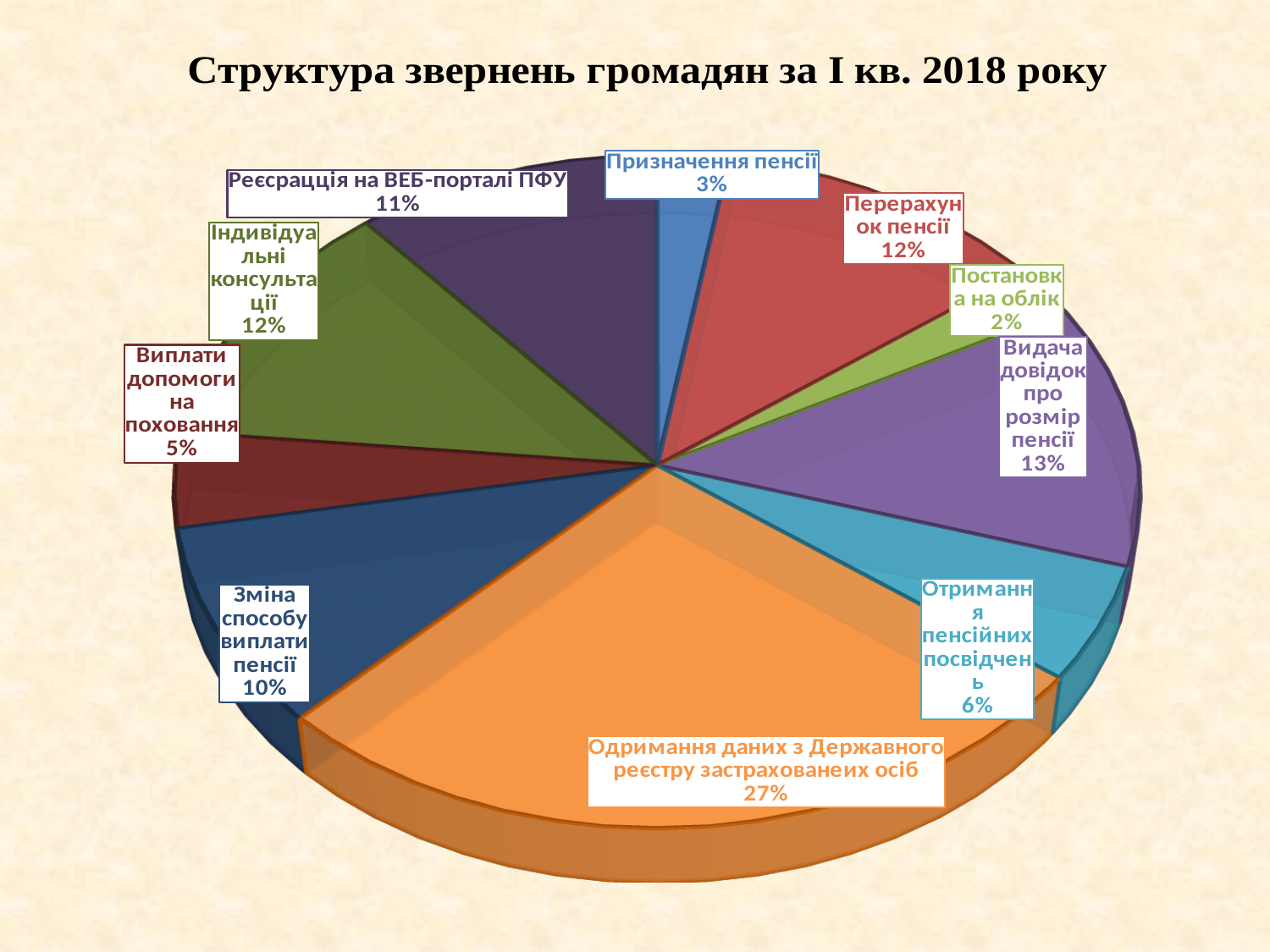
What kind of chart is shown on the slide? pie chart Which is larger: "Реєсрацція на ВЕБ-порталі ПФУ" or "Виплати допомоги на поховання"? Реєсрацція на ВЕБ-порталі ПФУ What percentage is shown for "Постановка на облік"? 2% How many slices does the pie chart have? 10 What percentage is shown for "Зміна способу виплати пенсії"? 10% Which category has the largest share of the pie? Одримання даних з Державного реєстру застрахованеих осіб What percentage is shown for "Видача довідок про розмір пенсії"? 13% What is the title of the chart? Структура звернень громадян за І кв. 2018 року Which category has the smallest share of the pie? Постановка на облік What share of the pie is "Одримання даних з Державного реєстру застрахованеих осіб"? 27% What percentage is shown for "Отримання пенсійних посвідчень"? 6% What is the difference in percentage points between "Перерахунок пенсії" and "Призначення пенсії"? 9